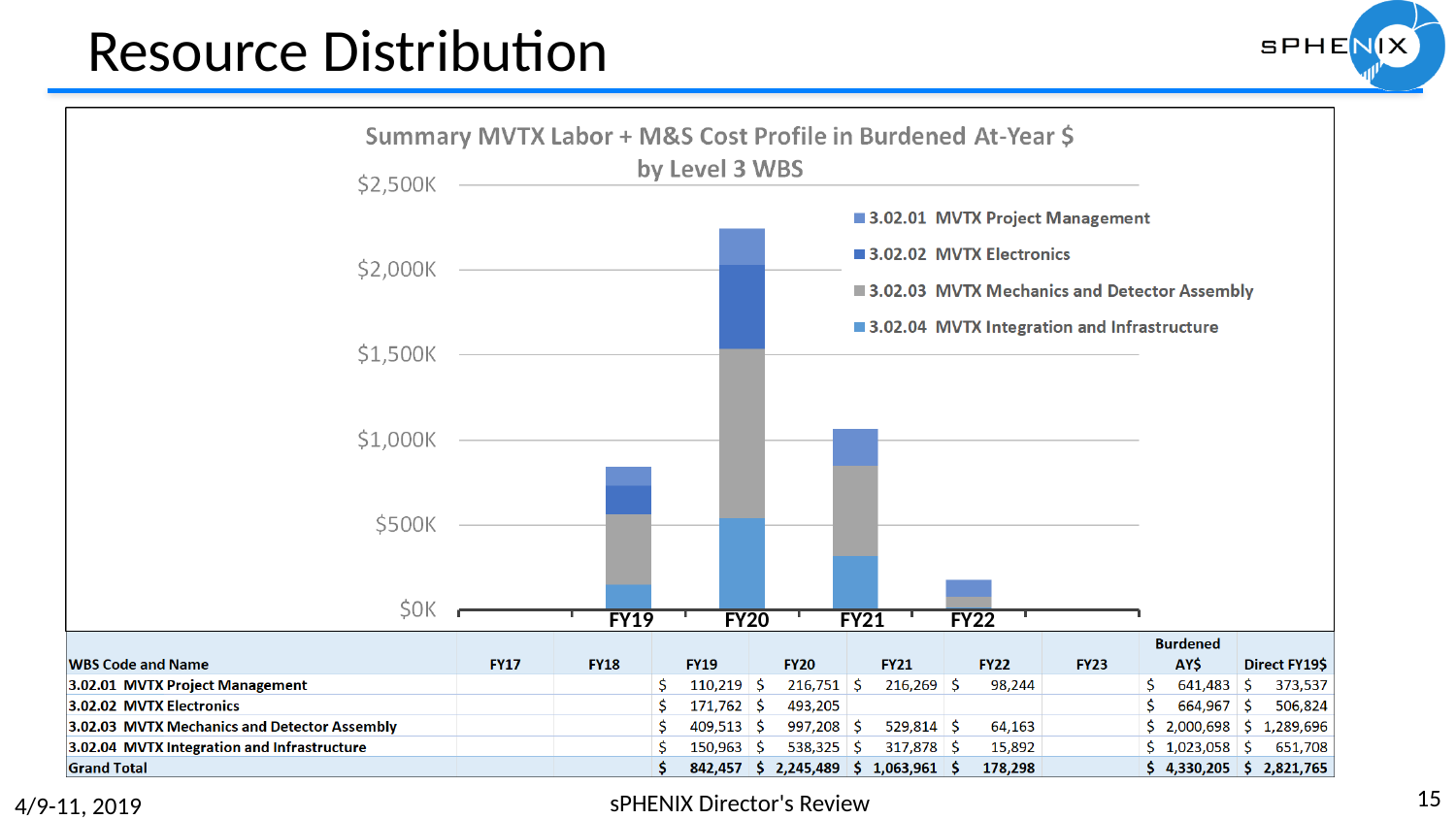
Which legend series is shown in grey in the stacked bars? 3.02.03 MVTX Mechanics and Detector Assembly How many fiscal years have bars plotted in the chart? 4 Which fiscal year has the shortest stacked bar in the chart? FY22 Which fiscal year has the tallest stacked bar in the chart? FY20 Is the total stacked bar for FY20 greater or less than $2,000K? greater Is the total stacked bar for FY19 greater or less than $1,000K? less Using the Grand Total row, what is the difference between the FY20 and FY21 totals? 1,181,528 How many series does the chart legend list? 4 Which stacked bar is taller, FY19 or FY21? FY21 According to the table, what is the Grand Total for FY19? 842,457 According to the table, what is the FY20 value for 3.02.02 MVTX Electronics? 493,205 What kind of chart is shown on the slide? Stacked bar chart